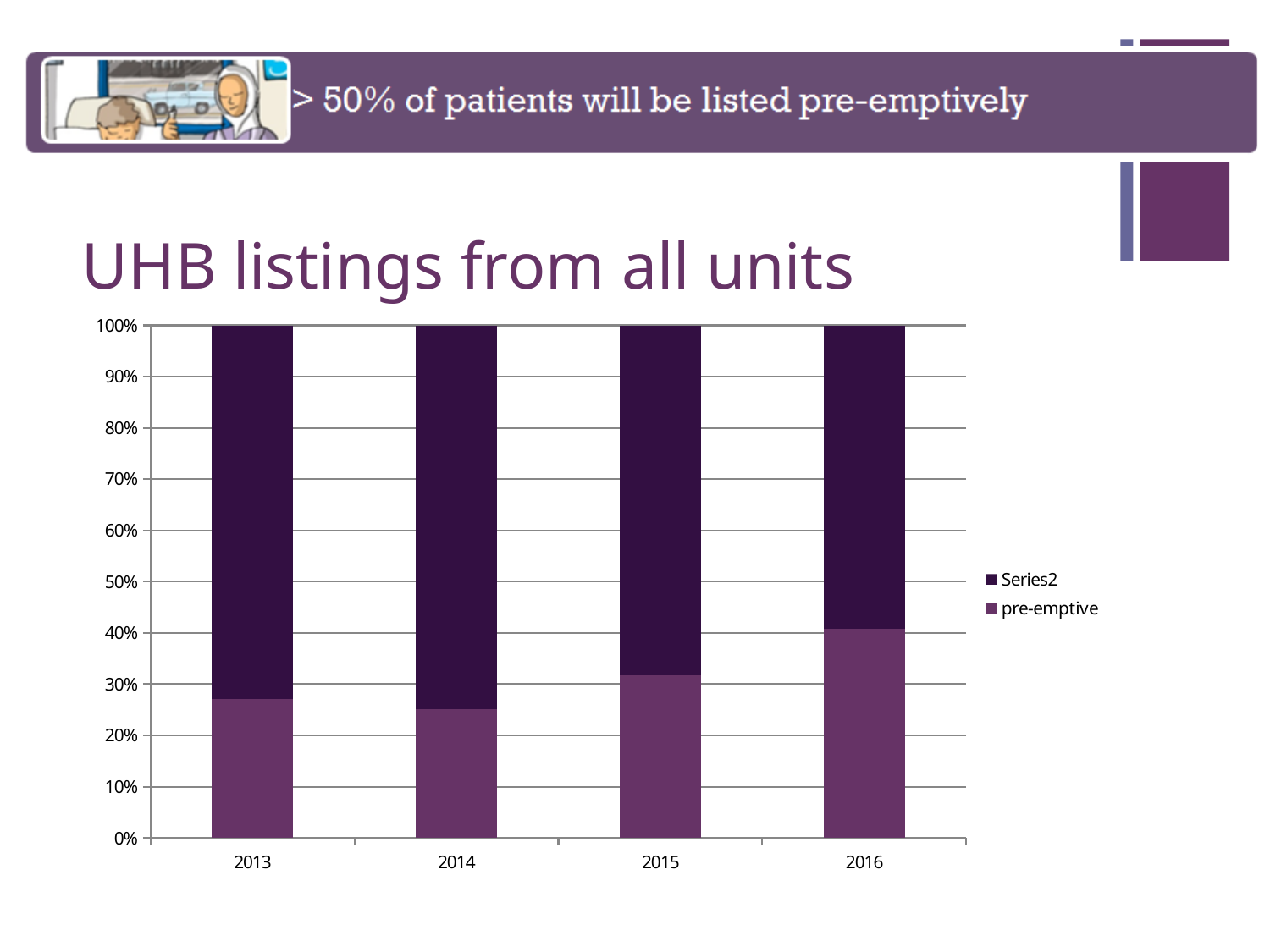
Which series is shown in the lighter purple colour at the bottom of each bar? pre-emptive How many series does the legend list? 2 What is the title of the chart? UHB listings from all units What is the total height of each stacked bar? 100% Is the pre-emptive value for 2015 greater or less than 30%? greater Is the pre-emptive value for 2014 greater or less than 30%? less In which year is the pre-emptive share the highest? 2016 How many years are shown on the x axis? 4 Is the pre-emptive value for 2013 greater or less than 50%? less Which year has the larger pre-emptive share, 2014 or 2015? 2015 What kind of chart is shown on the slide? stacked bar chart